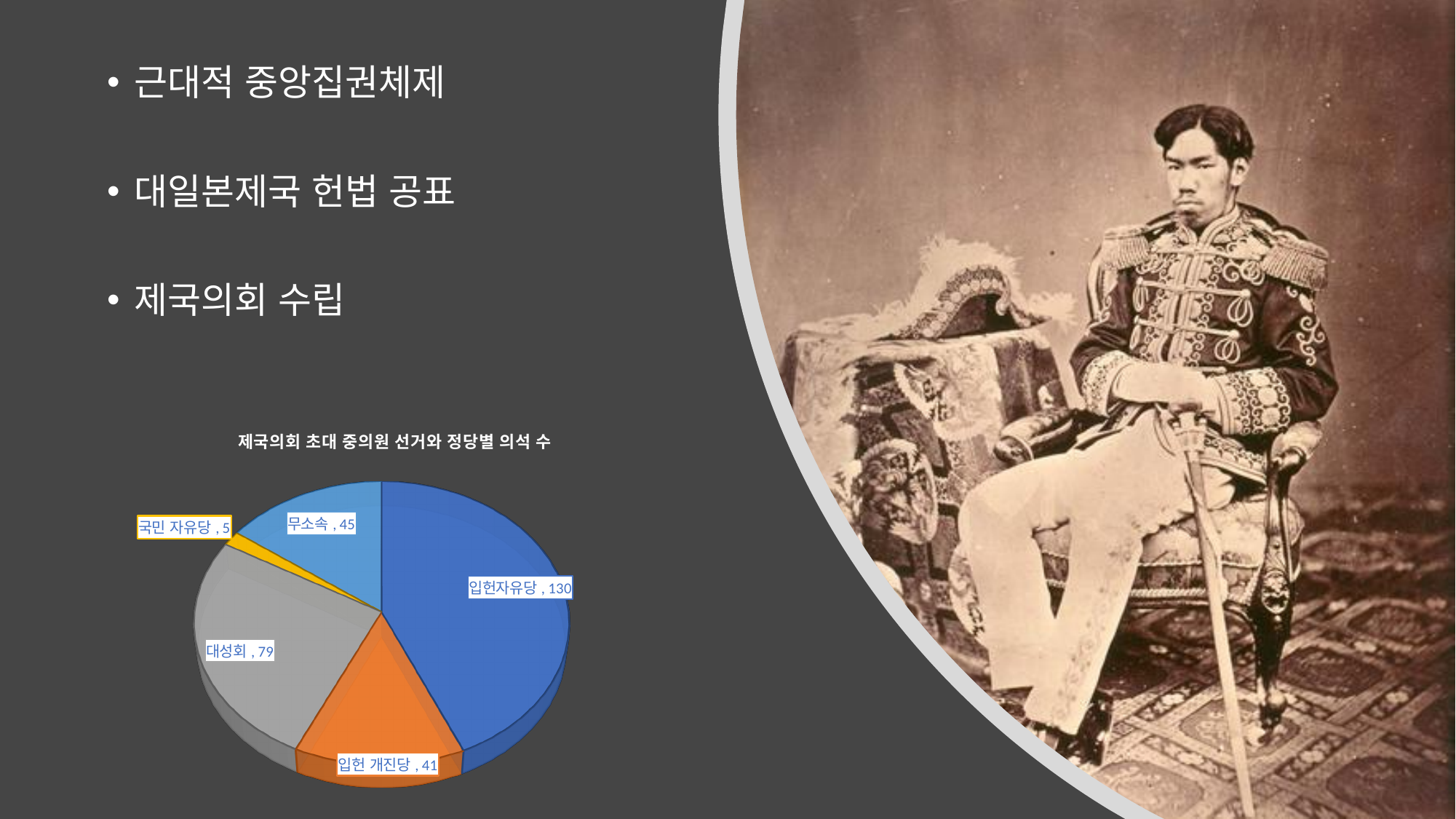
Which category has the smallest slice of the pie? 국민 자유당 Which party has the largest slice of the pie? 입헌자유당 Which is larger, the value for 무소속 or the value for 입헌 개진당? 무소속 What is the value for 무소속? 45 What is the title of the chart? 제국의회 초대 중의원 선거와 정당별 의석 수 What is the value for 대성회? 79 What is the difference between the values for 입헌자유당 and 대성회? 51 How many seats does 입헌자유당 have in the chart? 130 What is the total of all the values shown in the pie chart? 300 What kind of chart is shown on the slide? pie chart What is the value for 입헌 개진당? 41 How many categories are shown in the pie chart? 5